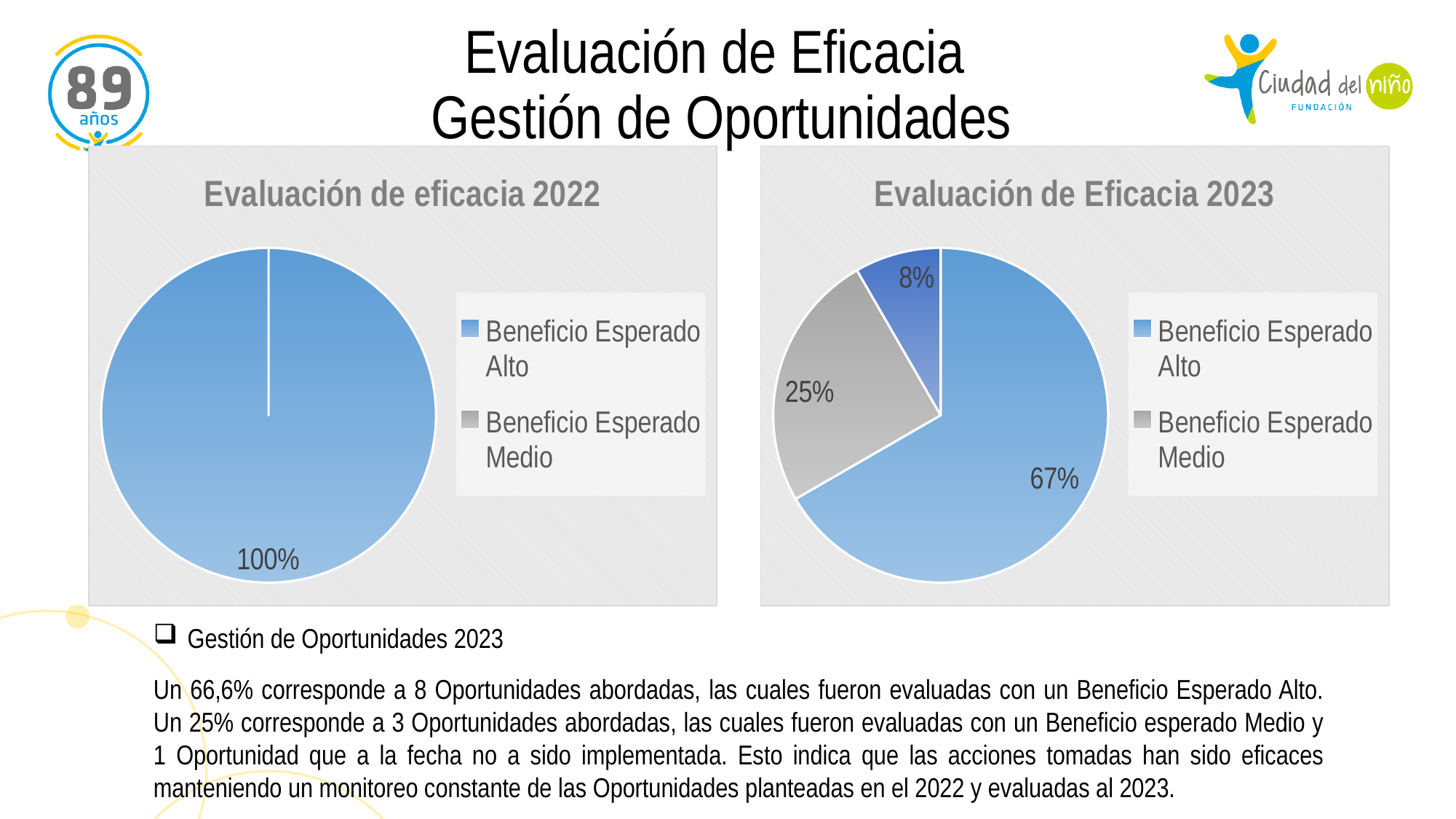
In the 'Evaluación de Eficacia 2023' chart, what is the smallest percentage labelled on the pie? 8% In the 'Evaluación de eficacia 2022' chart, what percentage is shown for Beneficio Esperado Alto? 100% How many slices does the pie in the 'Evaluación de Eficacia 2023' chart have? 3 In the 'Evaluación de Eficacia 2023' chart, what colour is the Beneficio Esperado Medio slice? Grey In the 'Evaluación de Eficacia 2023' chart, what percentage is shown for Beneficio Esperado Alto? 67% How many entries does the legend of the 'Evaluación de eficacia 2022' chart list? 2 In the 'Evaluación de Eficacia 2023' chart, what is the difference in percentage points between Beneficio Esperado Alto and Beneficio Esperado Medio? 42 In the 'Evaluación de Eficacia 2023' chart, which is larger: Beneficio Esperado Alto or Beneficio Esperado Medio? Beneficio Esperado Alto What is the title of the chart on the right side of the slide? Evaluación de Eficacia 2023 What type of chart is 'Evaluación de eficacia 2022'? Pie chart In the 'Evaluación de Eficacia 2023' chart, which category has the largest slice? Beneficio Esperado Alto In the 'Evaluación de Eficacia 2023' chart, what percentage is shown for Beneficio Esperado Medio? 25%